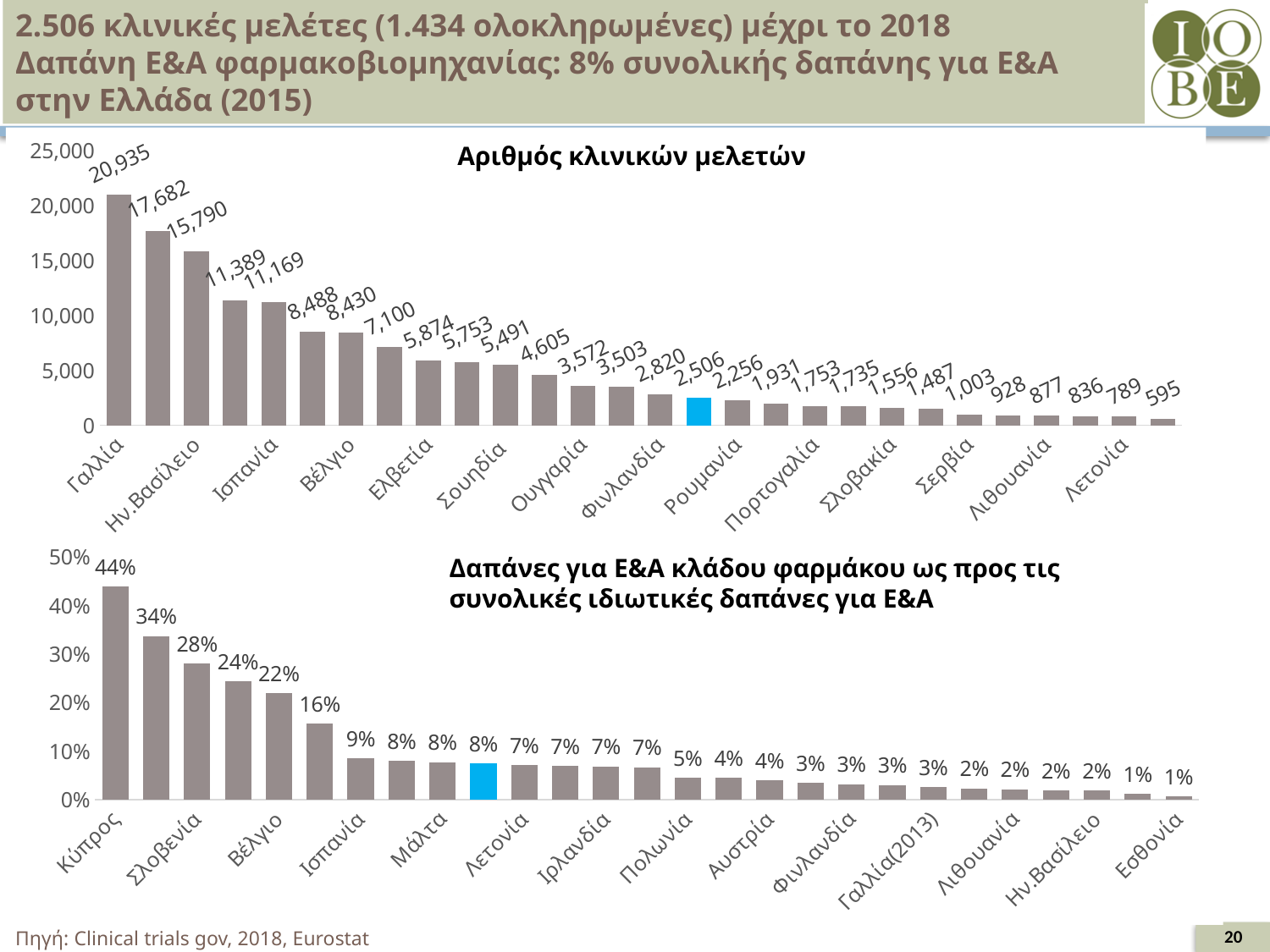
In the chart 'Αριθμός κλινικών μελετών', what is the value for Γαλλία? 20,935 In the bottom chart on pharmaceutical R&D spending share, what is the difference between Κύπρος (44%) and Σλοβενία (28%)? 16% In the chart 'Αριθμός κλινικών μελετών', what is the value of the highlighted blue bar? 2,506 In the bottom chart on pharmaceutical R&D spending share, which is larger: the value for Κύπρος or the value for Βέλγιο? Κύπρος In the chart 'Αριθμός κλινικών μελετών', what is the difference between the highest value (20,935) and the highlighted blue bar (2,506)? 18,429 In the bottom chart on pharmaceutical R&D spending share, what is the value of the highlighted blue bar? 8% In the chart 'Αριθμός κλινικών μελετών', what is the lowest value shown? 595 In the bottom chart on pharmaceutical R&D spending share, what is the value for Κύπρος? 44% In the bottom chart on pharmaceutical R&D spending share, what is the value for Σλοβενία? 28% In the chart 'Αριθμός κλινικών μελετών', which country has the highest number of clinical trials? Γαλλία What type of chart is 'Αριθμός κλινικών μελετών'? bar chart In the chart 'Αριθμός κλινικών μελετών', do the values rise or fall from left to right? fall